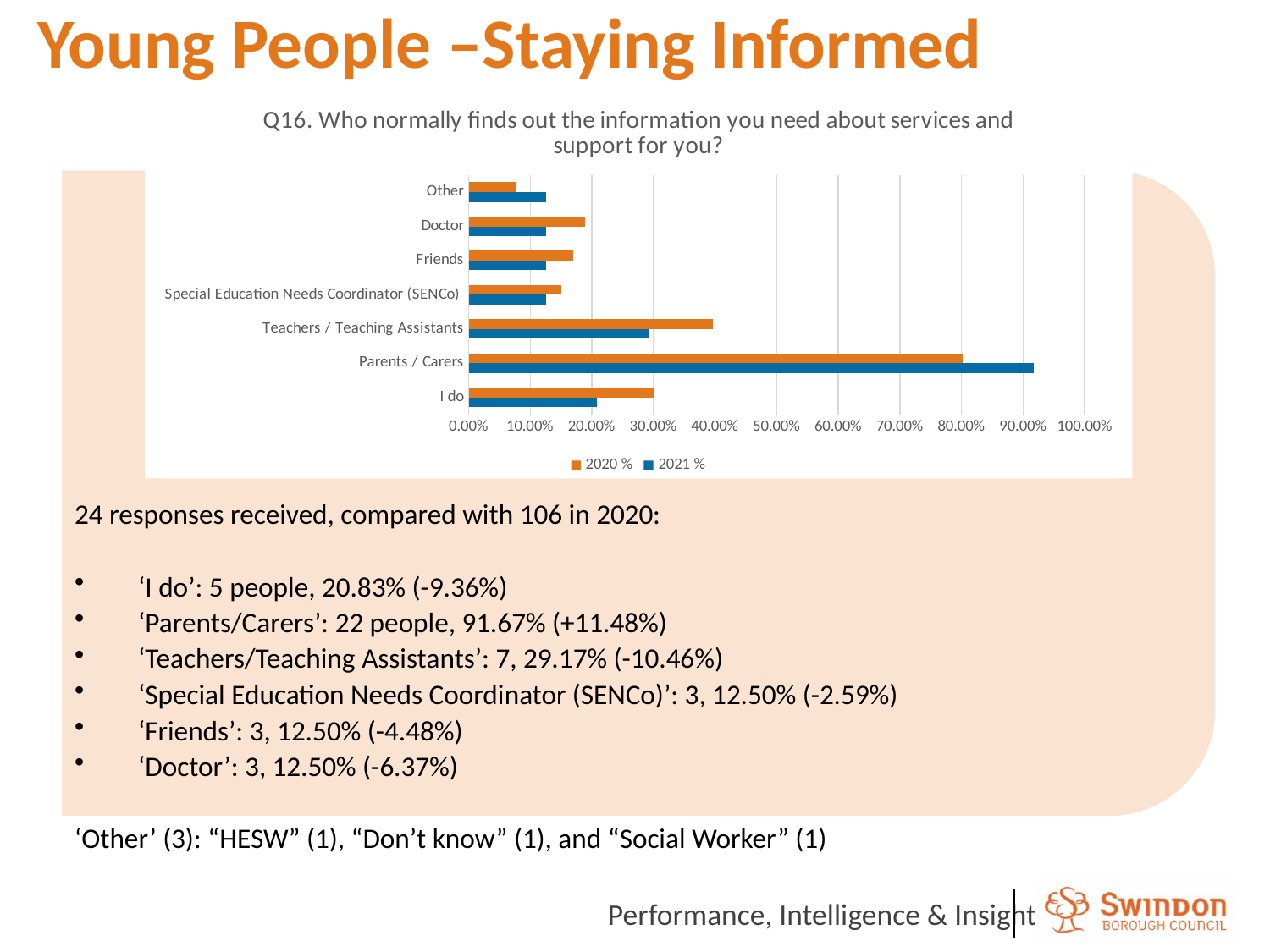
For Teachers / Teaching Assistants, which series has the larger value, 2020 % or 2021 %? 2020 % Is the 2021 % value for Parents / Carers greater or less than 90.00%? greater What kind of chart is shown on the slide? bar chart What is the title of the chart? Q16. Who normally finds out the information you need about services and support for you? Is the 2020 % value for Teachers / Teaching Assistants greater or less than 30.00%? greater Which series is shown in orange in the chart legend? 2020 % Which category has the highest value for 2021 %? Parents / Carers For Parents / Carers, which series has the larger value, 2020 % or 2021 %? 2021 % Which category has the lowest value for 2020 %? Other How many series does the chart legend list? 2 How many categories are shown on the chart? 7 Is the 2020 % value for Other greater or less than 10.00%? less